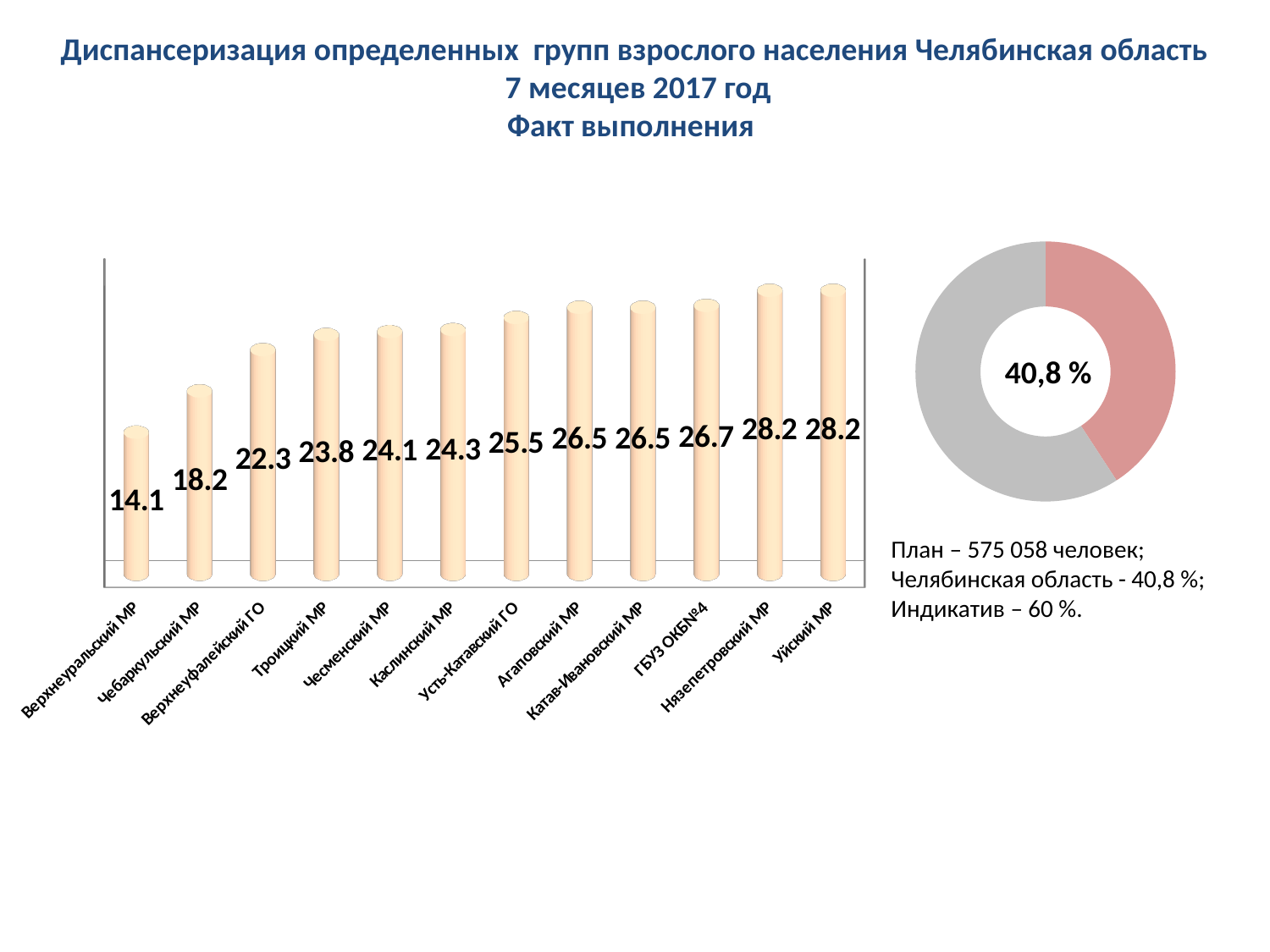
On the donut chart on the right, what share is shown by the label in the centre? 40,8 % What kind of chart is shown on the left of the slide? bar chart On the bar chart on the left, do the values rise or fall from left to right along the x axis? rise On the bar chart on the left, what is the value for Верхнеуральский МР? 14.1 On the bar chart on the left, which is larger: the value for Чесменский МР or the value for Нязепетровский МР? Нязепетровский МР On the bar chart on the left, which category has the lowest value? Верхнеуральский МР On the bar chart on the left, how many categories are shown? 12 On the bar chart on the left, what is the difference between the values for Верхнеуфалейский ГО and Чебаркульский МР? 4.1 On the bar chart on the left, what is the value for Усть-Катавский ГО? 25.5 On the bar chart on the left, what is the difference between the values for Уйский МР and Верхнеуральский МР? 14.1 On the bar chart on the left, what is the value for Троицкий МР? 23.8 On the bar chart on the left, what is the value for ГБУЗ ОКБ№4? 26.7